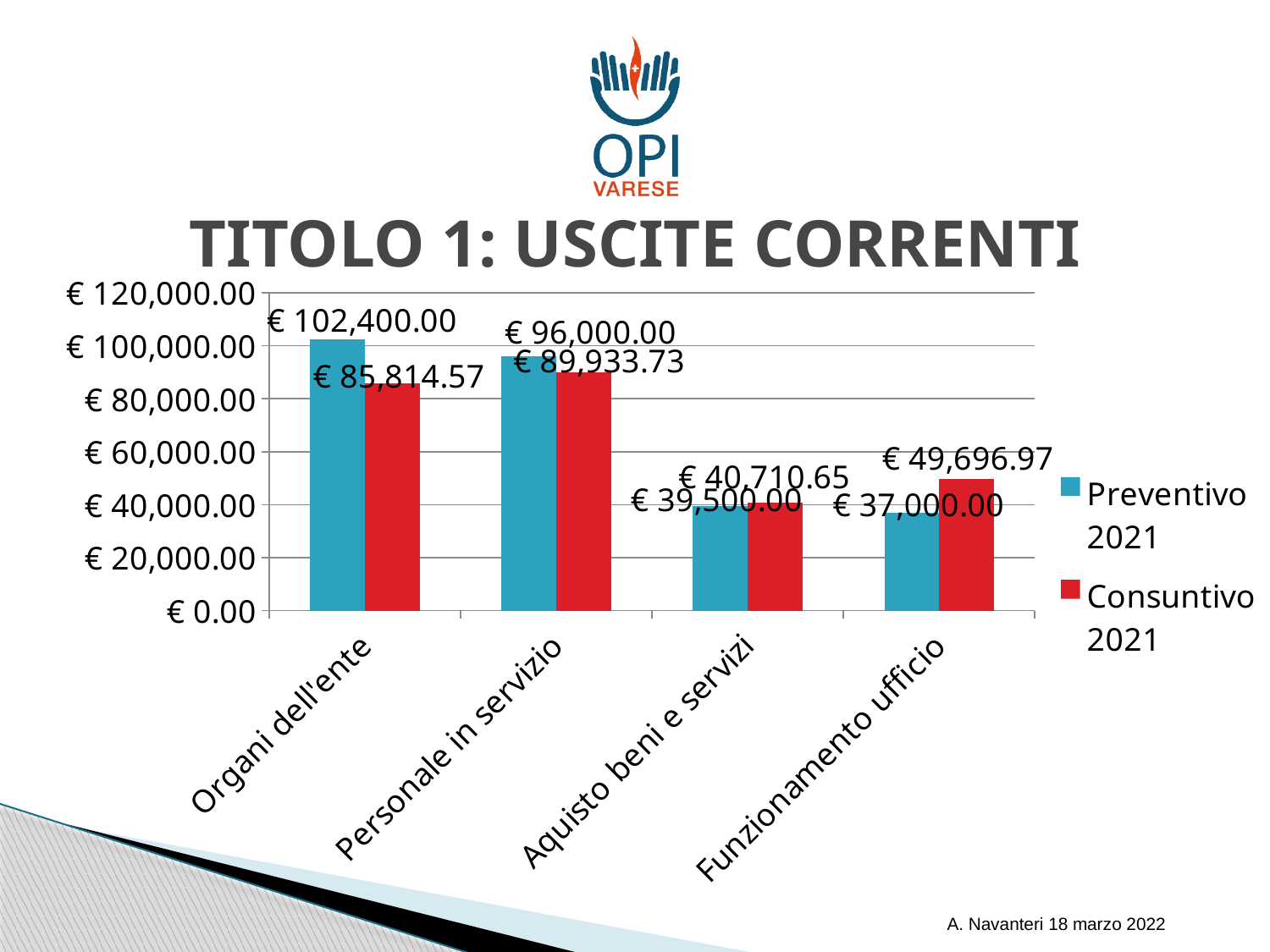
What is the Preventivo 2021 value for Organi dell'ente? € 102,400.00 How many series does the chart legend list? 2 What is the difference between the Preventivo 2021 and Consuntivo 2021 values for Organi dell'ente? € 16,585.43 What is the difference between the Consuntivo 2021 and Preventivo 2021 values for Funzionamento ufficio? € 12,696.97 For Personale in servizio, which is larger: the Preventivo 2021 value or the Consuntivo 2021 value? Preventivo 2021 How many categories are shown on the x axis of the chart? 4 What is the Preventivo 2021 value for Aquisto beni e servizi? € 39,500.00 Which category has the lowest Consuntivo 2021 value? Aquisto beni e servizi Which category has the highest Preventivo 2021 value? Organi dell'ente What type of chart is shown on the slide? Bar chart What is the Consuntivo 2021 value for Personale in servizio? € 89,933.73 What is the Consuntivo 2021 value for Funzionamento ufficio? € 49,696.97